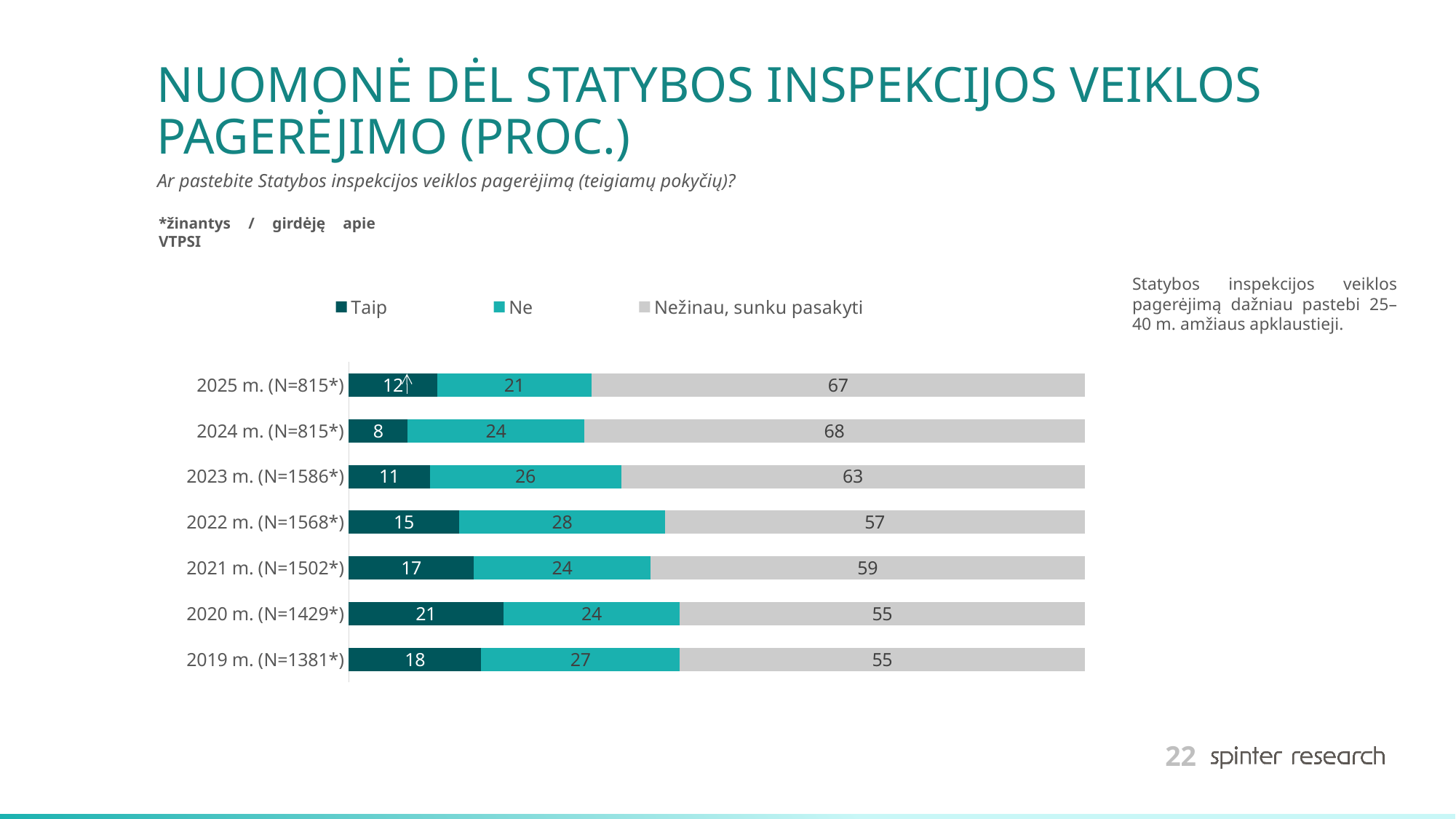
How many year categories are plotted in the chart? 7 Which year has the lowest value for "Taip"? 2024 m. (N=815*) What is the difference between the "Nežinau, sunku pasakyti" values for 2024 m. (N=815*) and 2019 m. (N=1381*)? 13 What is the total of the stacked bar for 2022 m. (N=1568*)? 100 How many series does the legend list? 3 What is the value for "Taip" in 2025 m. (N=815*)? 12 What is the value for "Nežinau, sunku pasakyti" in 2024 m. (N=815*)? 68 Which legend entry is shown in grey? Nežinau, sunku pasakyti What is the value for "Ne" in 2023 m. (N=1586*)? 26 Which is larger: the "Ne" value for 2022 m. (N=1568*) or for 2021 m. (N=1502*)? 2022 m. (N=1568*) Which year has the highest value for "Taip"? 2020 m. (N=1429*) What kind of chart is shown on the slide? stacked bar chart